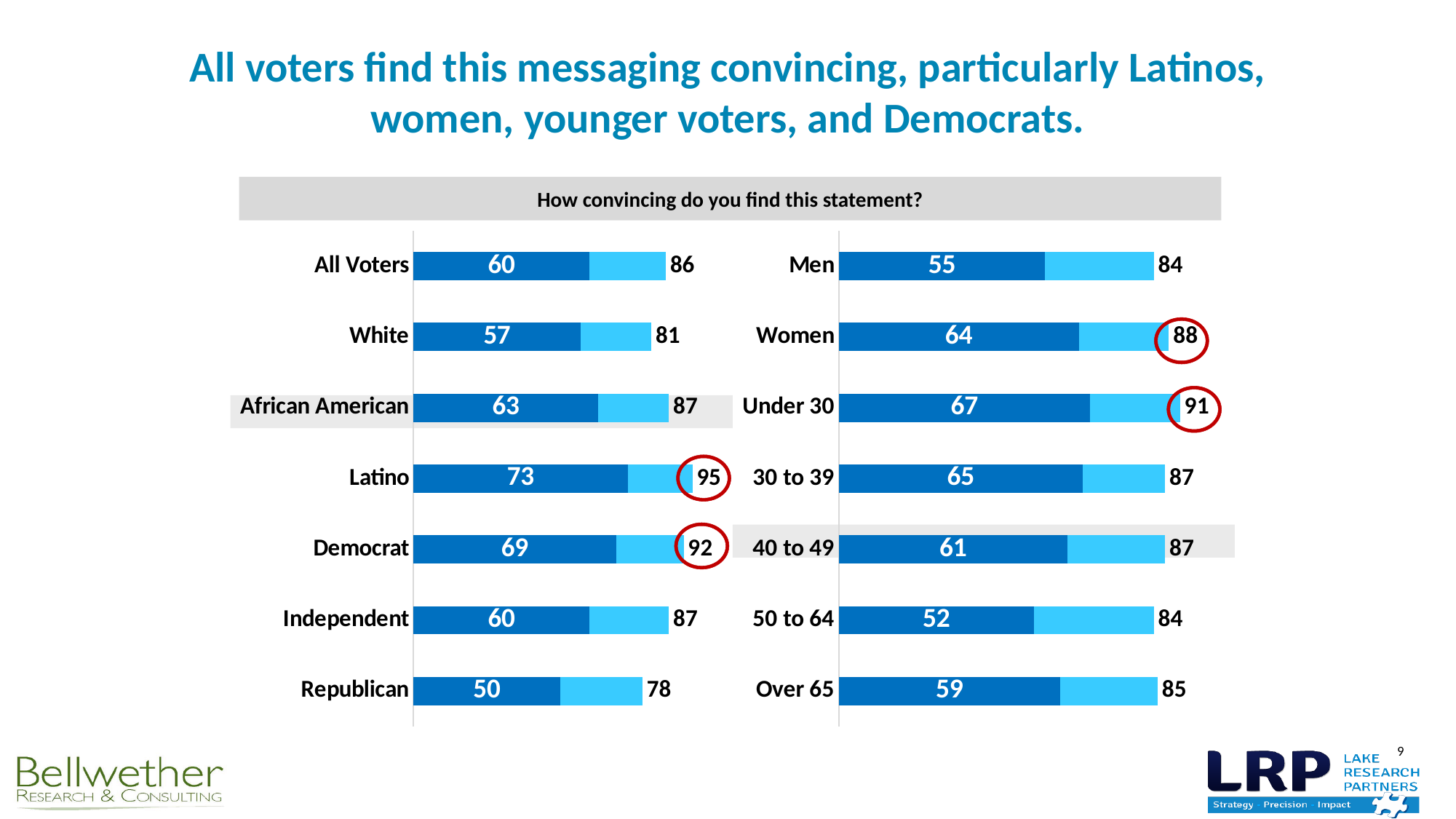
How many categories are shown in the left chart? 7 In the left chart, what is the difference between the total for Latino and the total for Republican? 17 In the right chart, what is the value printed inside the dark blue bar for Under 30? 67 In the left chart, what is the total value printed at the end of the Republican bar? 78 In the right chart, which has the larger total value, Women or Men? Women What kind of chart is used on this slide? Bar chart In the right chart, which category has the highest total value? Under 30 In the right chart, which category has the lowest dark blue value? 50 to 64 In the left chart, which category has the highest total value? Latino In the left chart, what is the value printed inside the dark blue bar for Latino? 73 What question is shown in the grey header above the charts? How convincing do you find this statement? In the left chart, which category has the lowest total value? Republican